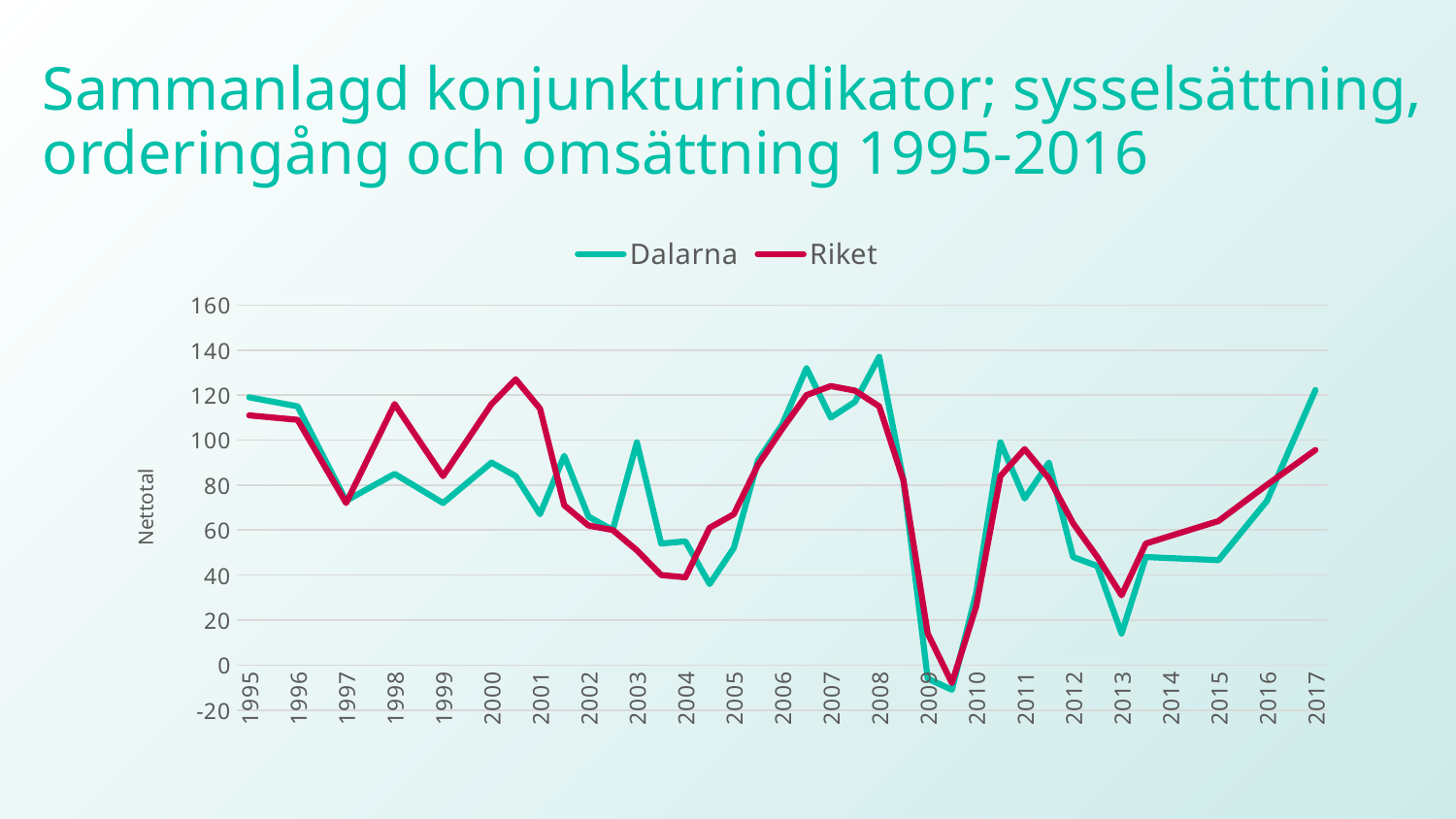
Which series has the higher value in 2013, Dalarna or Riket? Riket In which year does the Dalarna line reach its lowest point? 2009 How many year labels are shown along the x axis? 23 Is the value for Dalarna in 2017 greater or less than 100? greater What kind of chart is shown on the slide? line chart Is the value for Riket in 2017 greater or less than 100? less Do the values for both series rise or fall from 2015 to 2017? rise What is the label on the vertical axis? Nettotal What are the two series named in the legend? Dalarna and Riket How many series does the legend list? 2 Which series has the higher value in 2017, Dalarna or Riket? Dalarna Is the value for Dalarna in 2013 greater or less than 20? less